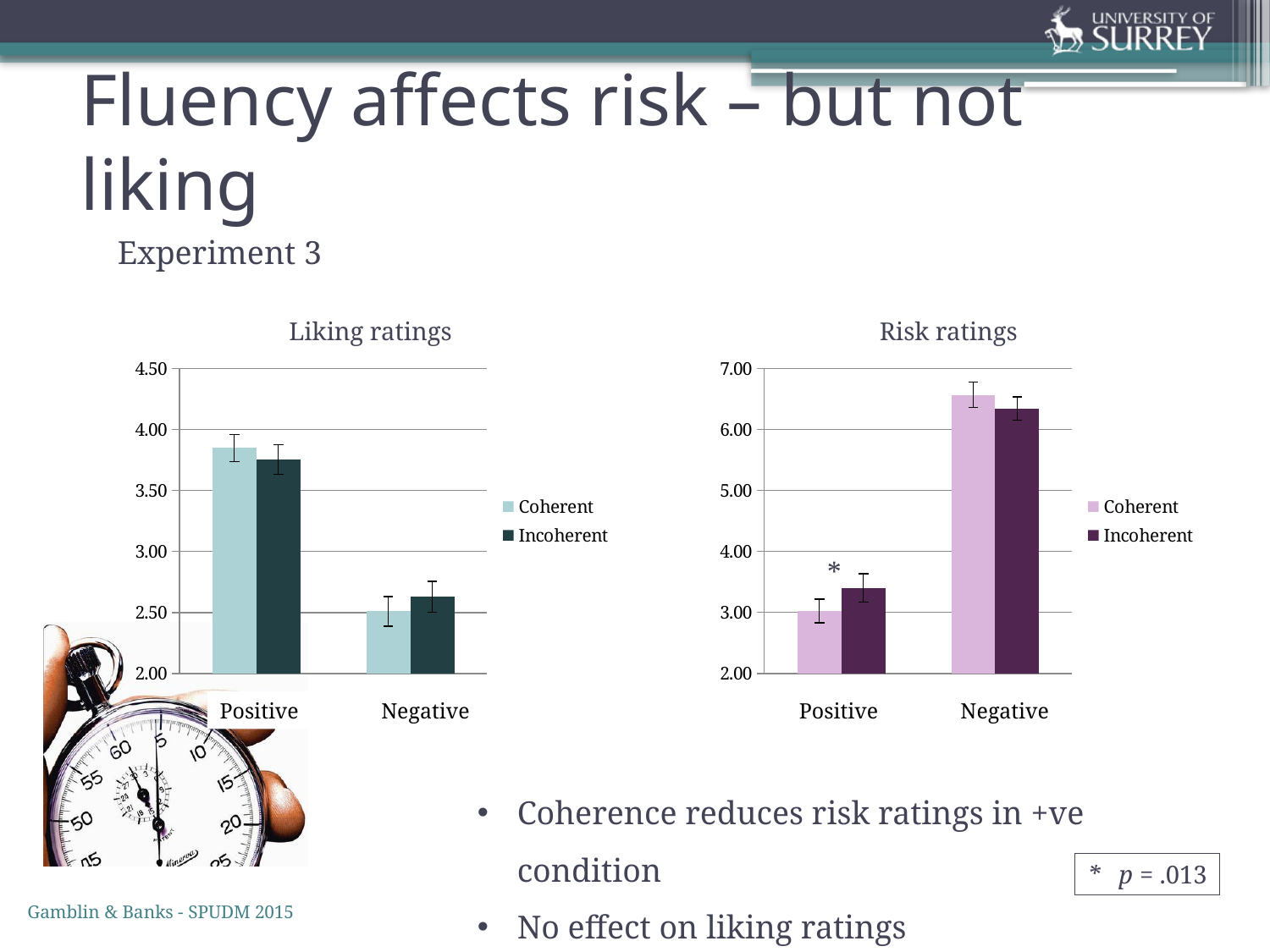
What kind of chart is the Liking ratings chart? bar chart What are the two legend entries in the Liking ratings chart? Coherent and Incoherent In the Risk ratings chart, which category has the highest bar? Negative In the Liking ratings chart, which category has the larger Coherent value: Positive or Negative? Positive In the Risk ratings chart, do the values rise or fall from Positive to Negative? rise In the Liking ratings chart, is the Incoherent value for Negative greater or less than 3.00? less How many categories are shown on the x axis of the Liking ratings chart? 2 In the Risk ratings chart, is the Coherent value for Positive greater or less than 4.00? less In the Risk ratings chart, is the Coherent value for Negative greater or less than 6.00? greater How many series does the legend of the Risk ratings chart list? 2 In the Risk ratings chart, which is larger for Positive: Coherent or Incoherent? Incoherent